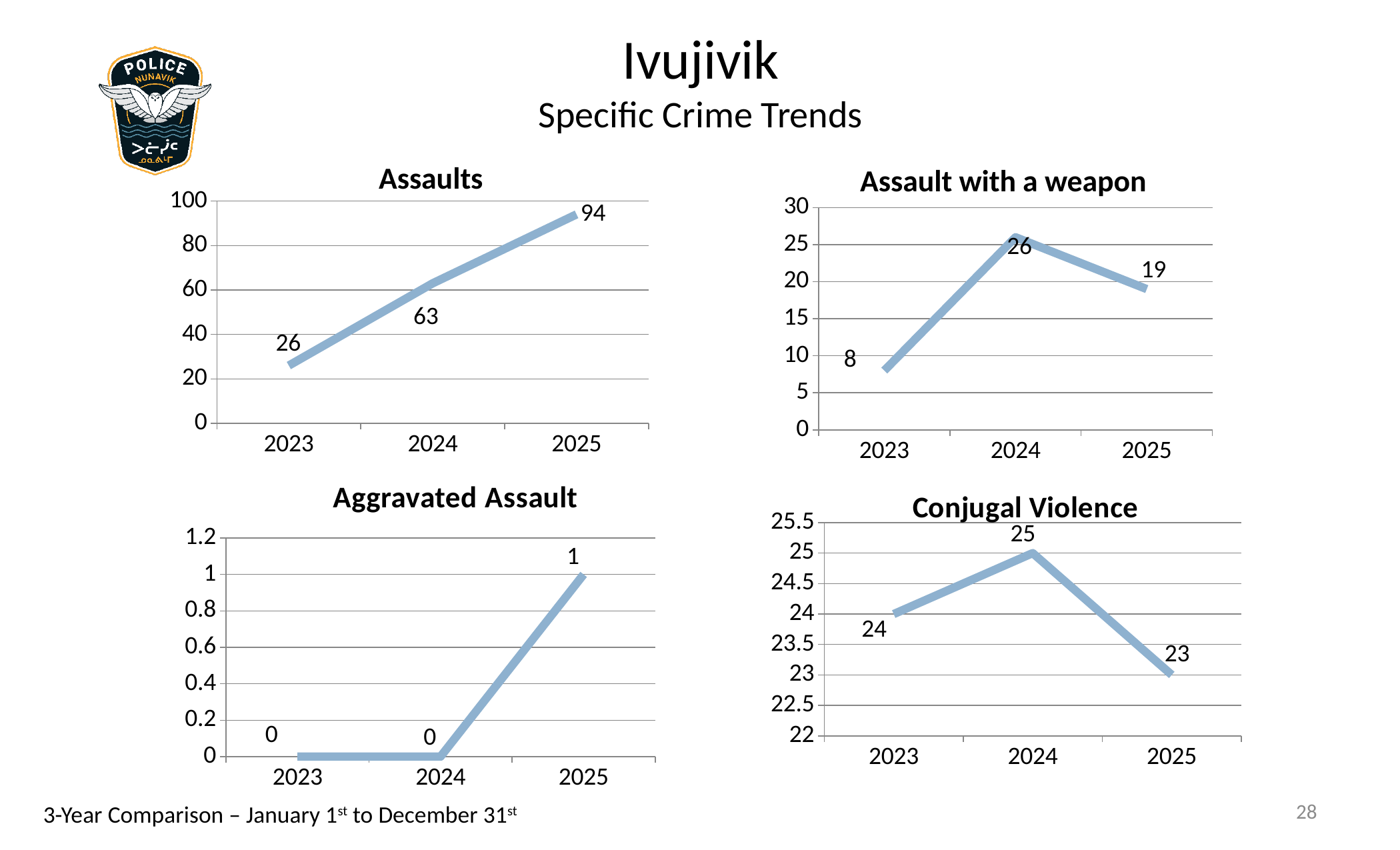
In the Assault with a weapon chart, what is the value for 2023? 8 In the Assault with a weapon chart, which is larger, the value for 2024 or the value for 2025? 2024 In the Assaults chart, do the values rise or fall from 2023 to 2025? rise In the Assaults chart, what is the difference between the 2025 and 2023 values? 68 In the Assaults chart, what is the value for 2025? 94 In the Conjugal Violence chart, what is the difference between the 2024 and 2025 values? 2 What kind of chart is the Conjugal Violence chart? line chart How many charts are shown on the slide? 4 In the Aggravated Assault chart, how many years are plotted? 3 In the Assault with a weapon chart, which year has the highest value? 2024 In the Aggravated Assault chart, what is the value for 2025? 1 In the Conjugal Violence chart, which year has the lowest value? 2025